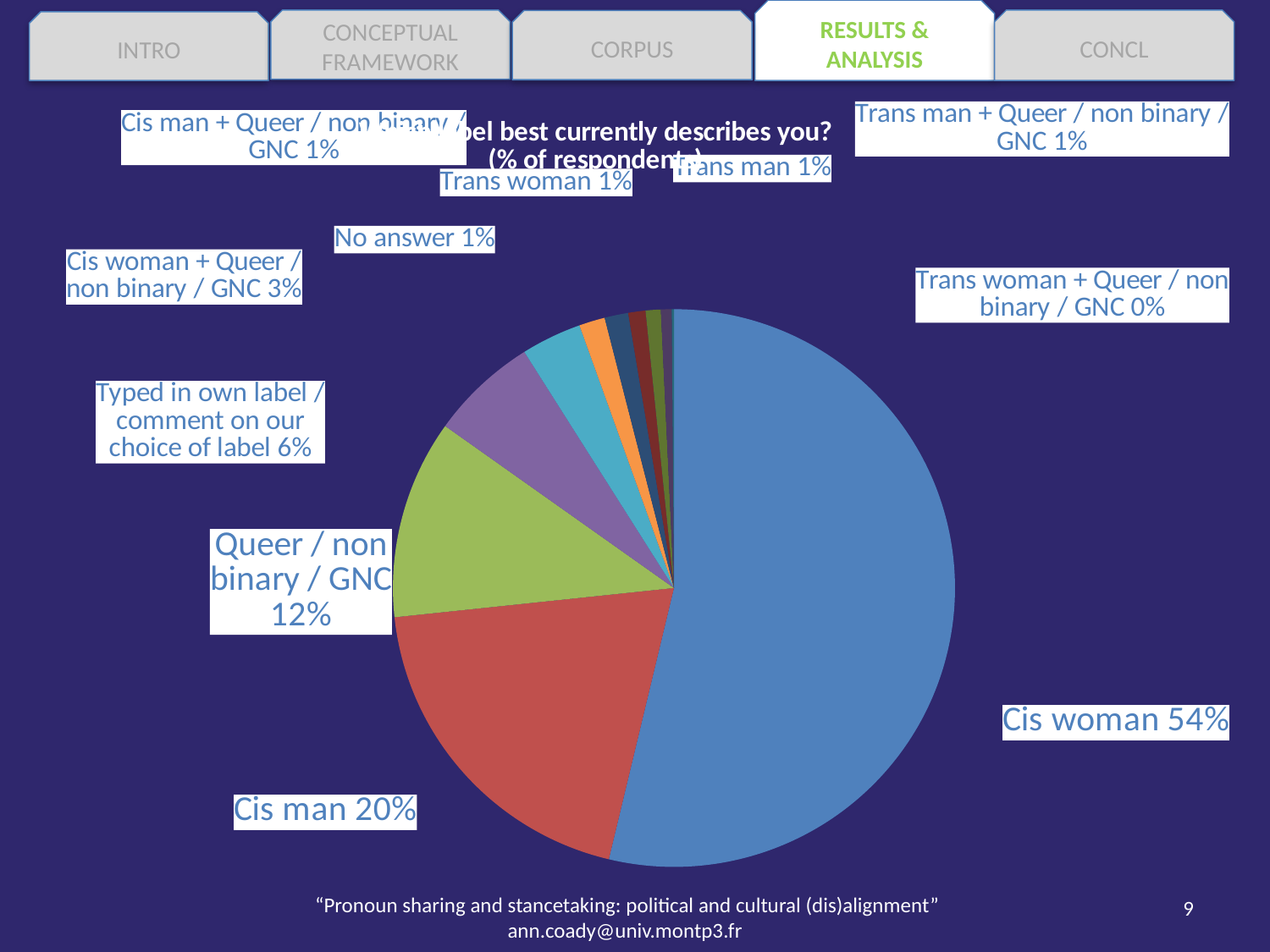
What percentage of respondents selected "Cis woman + Queer / non binary / GNC"? 3% What percentage of respondents selected "Cis man"? 20% What percentage of respondents selected "Queer / non binary / GNC"? 12% Which label has the smallest share of respondents? Trans woman + Queer / non binary / GNC Which label has the largest share of respondents? Cis woman What kind of chart is shown on the slide? pie chart How many labelled categories does the pie chart show? 11 What percentage of respondents typed in their own label or commented on the choice of label? 6% Which has a larger share of respondents, "Queer / non binary / GNC" or "Typed in own label / comment on our choice of label"? Queer / non binary / GNC What percentage of respondents selected "Trans woman + Queer / non binary / GNC"? 0% What percentage of respondents selected "Cis woman"? 54% What is the difference in percentage points between "Cis woman" and "Cis man"? 34